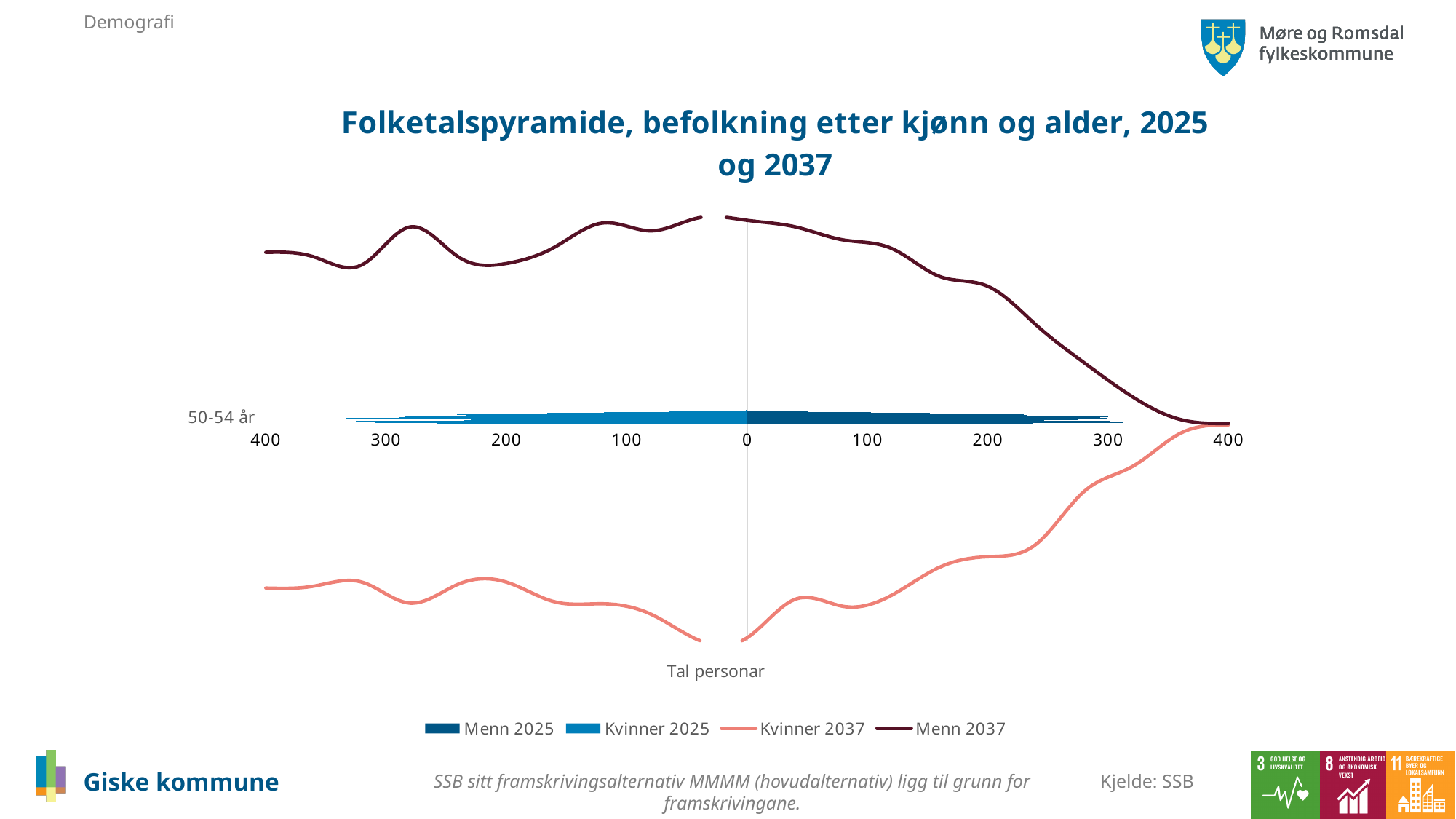
How many series does the legend list? 4 What is the label on the horizontal axis of the chart? Tal personar What is the title of the chart? Folketalspyramide, befolkning etter kjønn og alder, 2025 og 2037 What is the highest value shown on the horizontal axis of the chart? 400